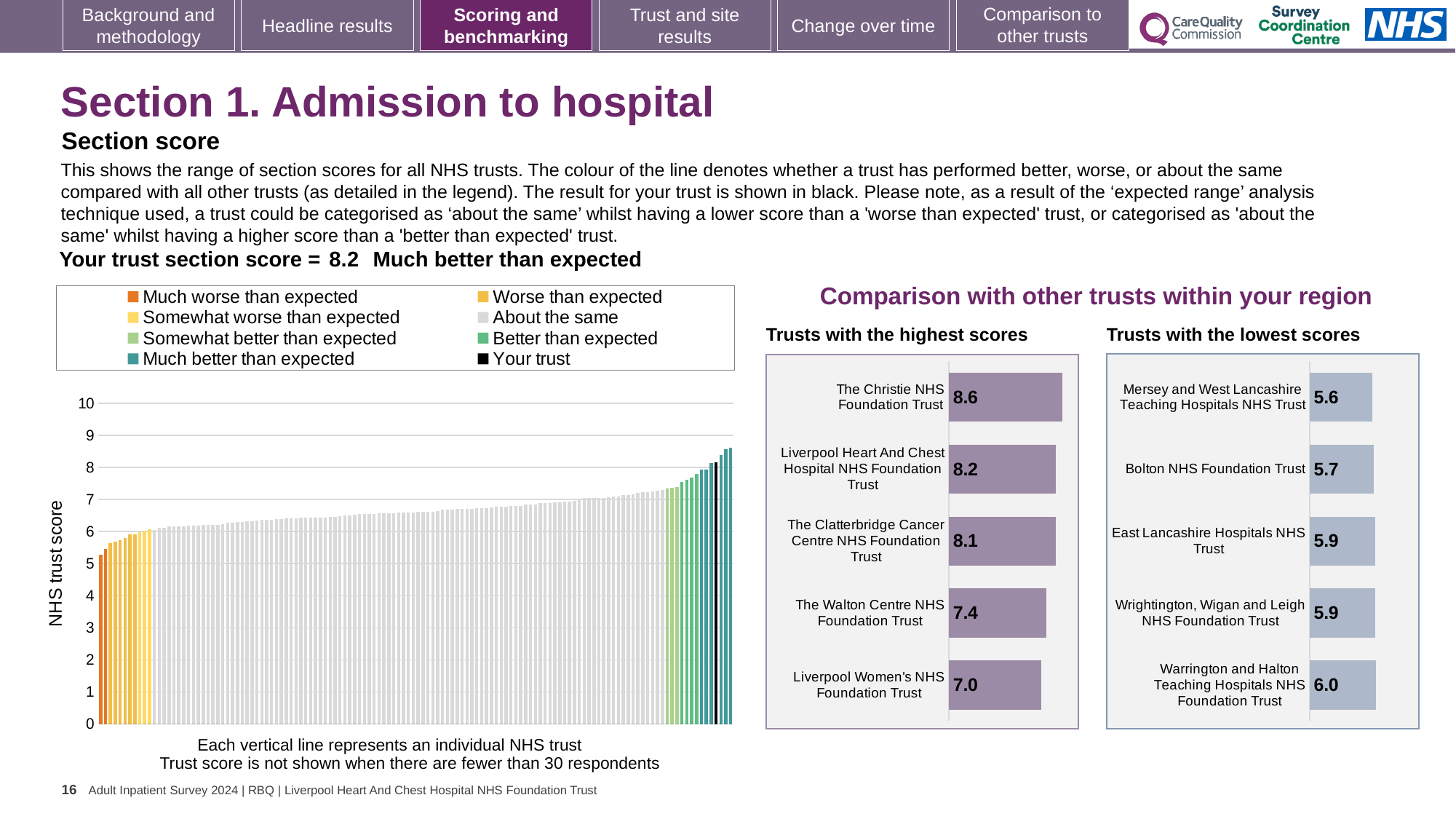
How many entries does the legend of the main 'NHS trust score' chart on the left list? 8 In the 'Trusts with the lowest scores' chart, which trust has the lowest score? Mersey and West Lancashire Teaching Hospitals NHS Trust In the 'Trusts with the highest scores' chart, what is the difference between the scores of The Christie NHS Foundation Trust and Liverpool Women's NHS Foundation Trust? 1.6 In the 'Trusts with the highest scores' chart, what is the score for The Walton Centre NHS Foundation Trust? 7.4 In the 'Trusts with the highest scores' chart, what is the score for The Christie NHS Foundation Trust? 8.6 In the 'Trusts with the lowest scores' chart, what is the difference between the scores of Warrington and Halton Teaching Hospitals NHS Foundation Trust and Mersey and West Lancashire Teaching Hospitals NHS Trust? 0.4 How many trusts are shown in the 'Trusts with the highest scores' chart? 5 In the 'Trusts with the lowest scores' chart, which has the higher score: Bolton NHS Foundation Trust or East Lancashire Hospitals NHS Trust? East Lancashire Hospitals NHS Trust In the main 'NHS trust score' chart on the left, do the values rise or fall from left to right along the x axis? Rise In the 'Trusts with the lowest scores' chart, what is the score for Warrington and Halton Teaching Hospitals NHS Foundation Trust? 6.0 In the 'Trusts with the highest scores' chart, which trust has the highest score? The Christie NHS Foundation Trust What kind of chart is the 'Trusts with the lowest scores' chart? Bar chart